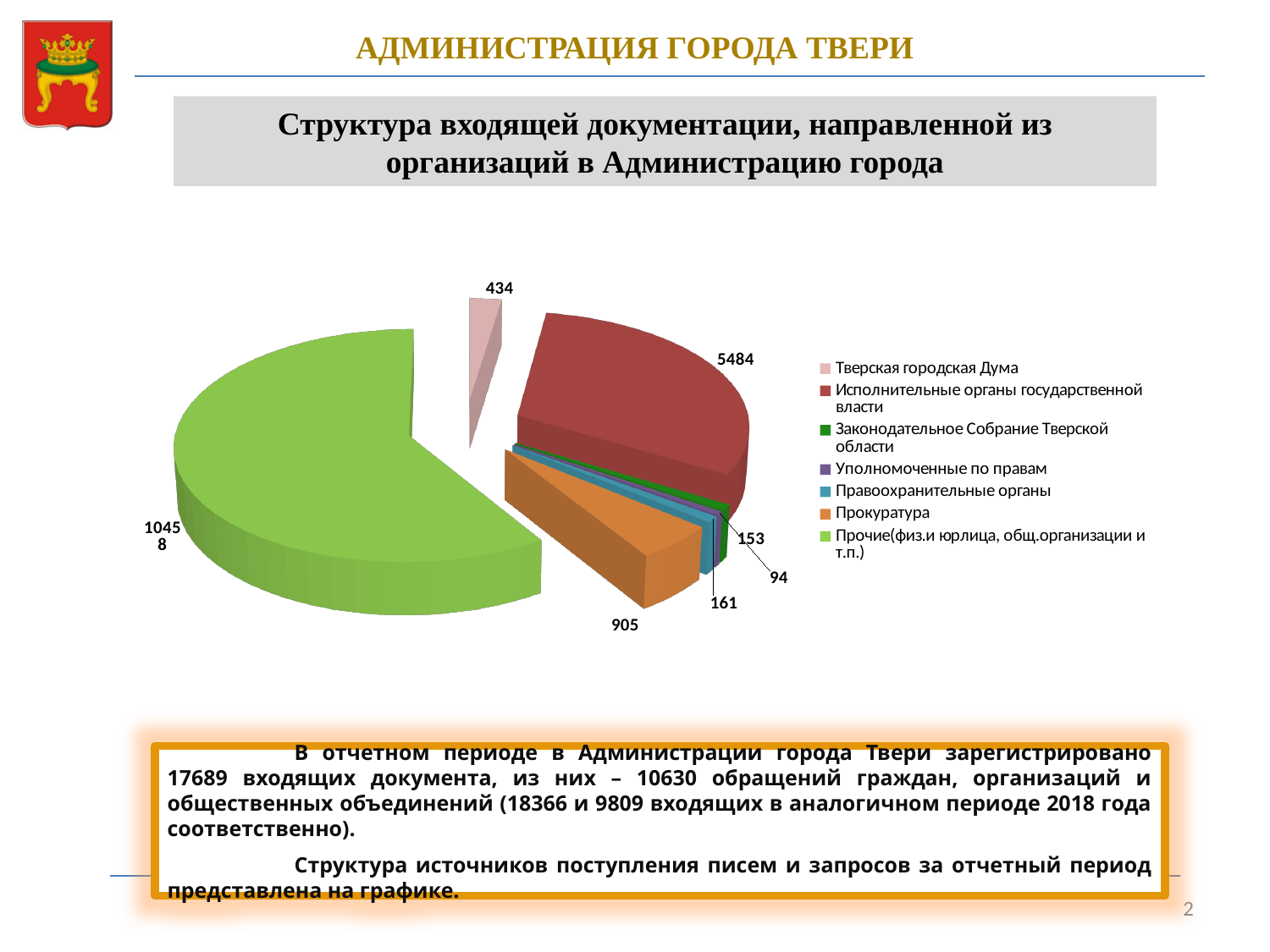
What is the difference between the values for Исполнительные органы государственной власти and Прокуратура? 4579 Which is larger: the value for Прокуратура or the value for Тверская городская Дума? Прокуратура What type of chart is shown on the slide? Pie chart How many categories does the legend of the pie chart list? 7 What is the value for Прокуратура? 905 What colour is the slice for Исполнительные органы государственной власти? Red Which category has the largest slice of the pie? Прочие(физ.и юрлица, общ.организации и т.п.) What is the value for Уполномоченные по правам? 94 What is the value for Правоохранительные органы? 161 What is the value for Исполнительные органы государственной власти? 5484 What is the value for Тверская городская Дума? 434 Which category has the smallest slice of the pie? Уполномоченные по правам